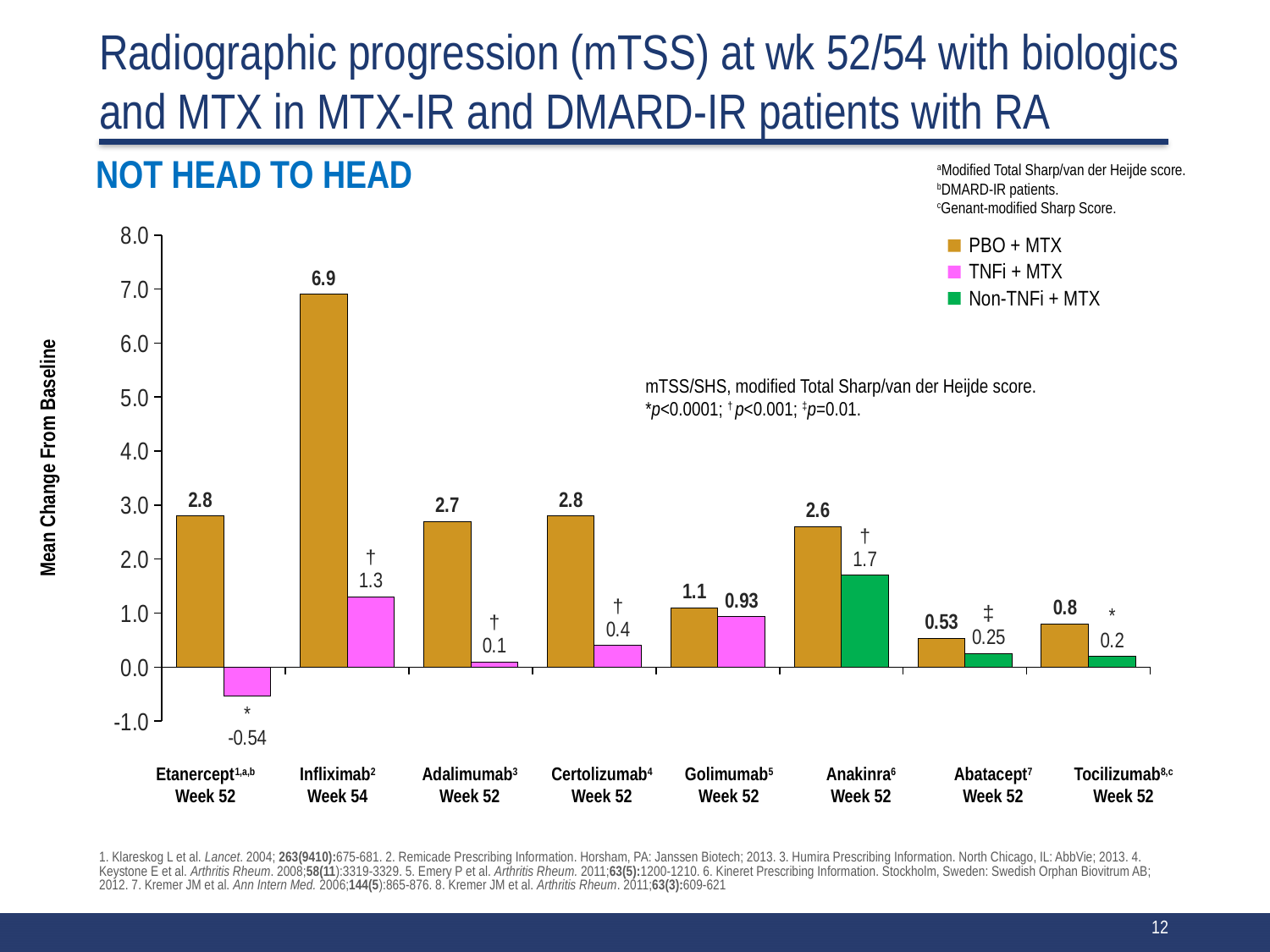
What is the Non-TNFi + MTX value for Anakinra at Week 52? 1.7 Which drug has the highest PBO + MTX value? Infliximab Which drug has the lowest biologic + MTX (TNFi or Non-TNFi) value? Etanercept What kind of chart is shown on the slide? Bar chart How many series does the legend list? 3 What is the difference between the PBO + MTX and TNFi + MTX values for Infliximab? 5.6 What is the PBO + MTX value for Infliximab at Week 54? 6.9 What is the difference between the PBO + MTX and Non-TNFi + MTX values for Tocilizumab? 0.6 What is the TNFi + MTX value for Etanercept at Week 52? -0.54 How many drugs are shown on the x axis of the chart? 8 What is the PBO + MTX value for Abatacept at Week 52? 0.53 Which is larger, the TNFi + MTX value for Golimumab or the TNFi + MTX value for Certolizumab? Golimumab